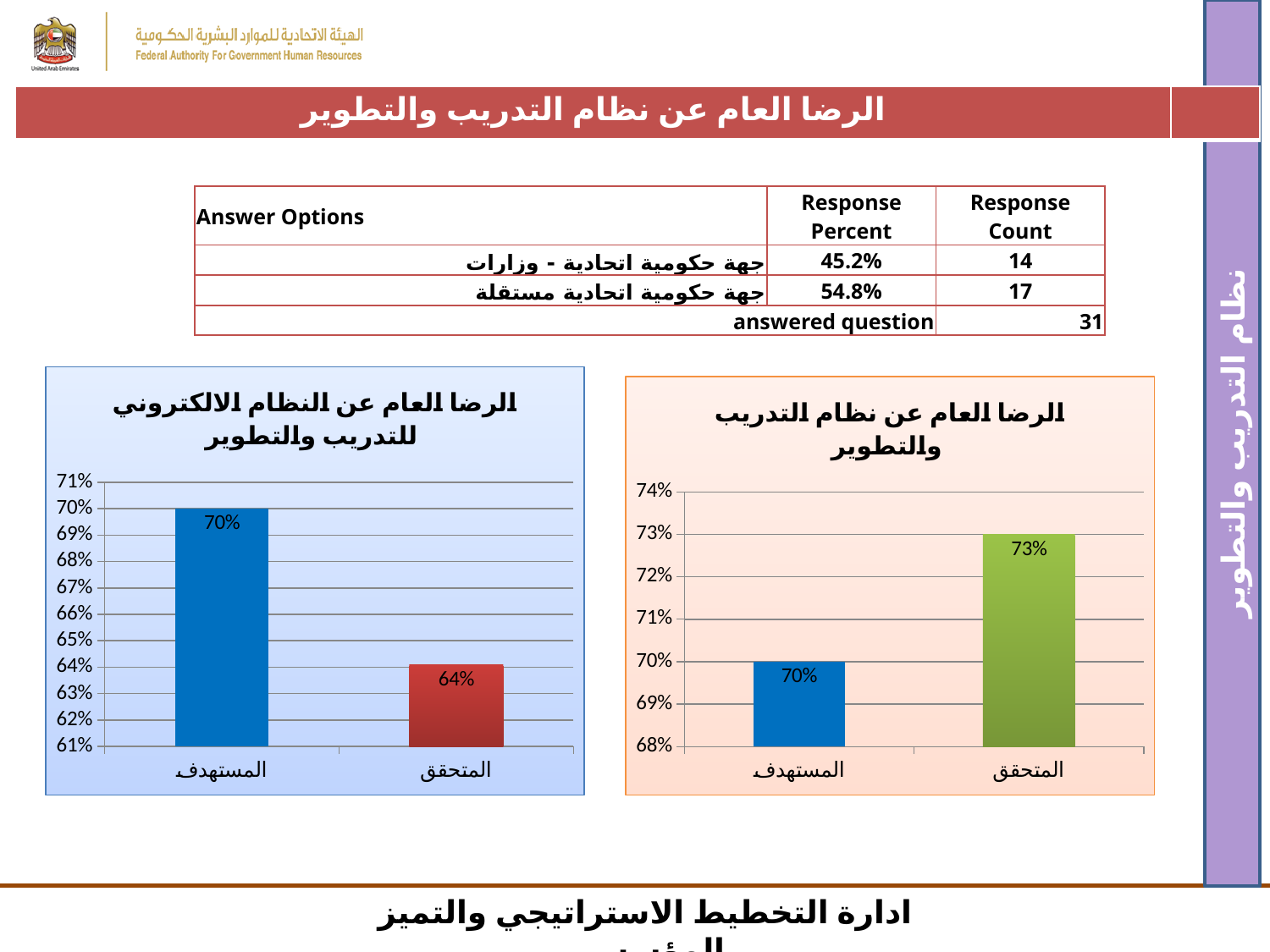
In the left chart (الرضا العام عن النظام الالكتروني للتدريب والتطوير), what is the value for المتحقق? 64% In the left chart, which category has the higher value, المستهدف or المتحقق? المستهدف In the left chart, is the value for المتحقق greater or less than 65%? less In the right chart (الرضا العام عن نظام التدريب والتطوير), what is the value for المتحقق? 73% What type of chart is the left chart? Bar chart In the right chart, what is the difference between المتحقق and المستهدف? 3% In the left chart, what is the difference between المستهدف and المتحقق? 6% In the right chart, which category has the highest value? المتحقق In the right chart (الرضا العام عن نظام التدريب والتطوير), what is the value for المستهدف? 70% In the left chart (الرضا العام عن النظام الالكتروني للتدريب والتطوير), what is the value for المستهدف? 70% How many bars are shown in the right chart? 2 What is the title of the right chart? الرضا العام عن نظام التدريب والتطوير